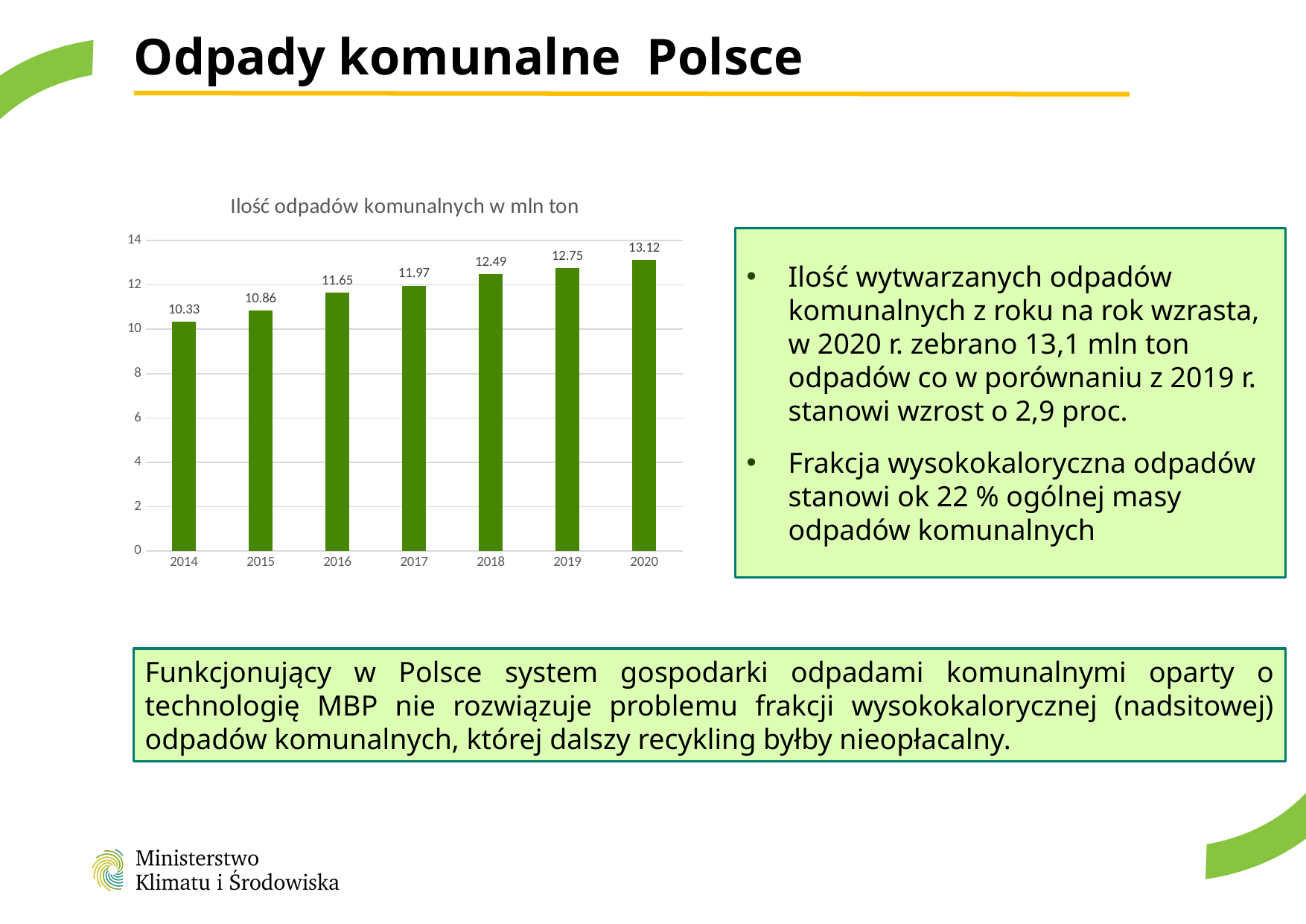
Which year has the lowest value? 2014 What kind of chart is shown on the slide? bar chart What is the value for 2017? 11.97 Do the values rise or fall from 2014 to 2020? rise What is the difference between the values for 2020 and 2019? 0.37 What is the value for 2020? 13.12 What is the value for 2014? 10.33 Is the value for 2019 greater or less than 12? greater Which year has the highest value? 2020 Which is larger, the value for 2018 or the value for 2015? 2018 What is the difference between the values for 2016 and 2014? 1.32 How many years are shown on the x axis? 7